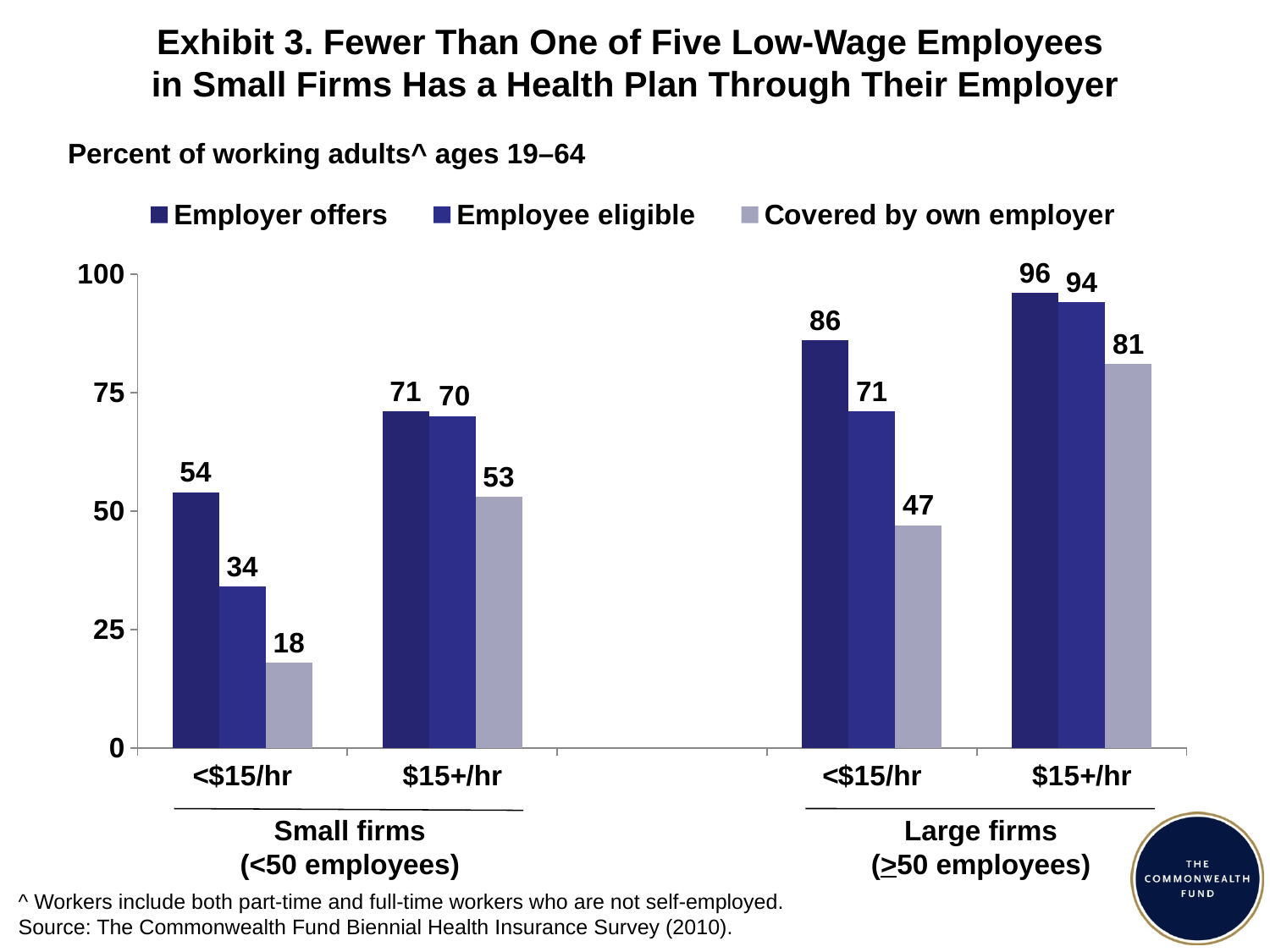
What percent of low-wage (<$15/hr) workers in small firms are covered by their own employer? 18 What is the 'Employer offers' value for $15+/hr workers in large firms? 96 How many series does the legend list? 3 Which group has the lowest 'Employer offers' value? <$15/hr in small firms What is the 'Employee eligible' value for <$15/hr workers in small firms? 34 What kind of chart is shown on the slide? Bar chart Which group has the highest 'Covered by own employer' value? $15+/hr in large firms Is the 'Covered by own employer' value higher for $15+/hr workers in small firms or for <$15/hr workers in large firms? $15+/hr workers in small firms What does the subtitle say the chart measures? Percent of working adults^ ages 19–64 What is the difference between 'Employer offers' and 'Covered by own employer' for <$15/hr workers in large firms? 39 What is the difference between the 'Employer offers' values for <$15/hr workers in large firms and small firms? 32 How many wage/firm-size groups are shown on the x axis? 4